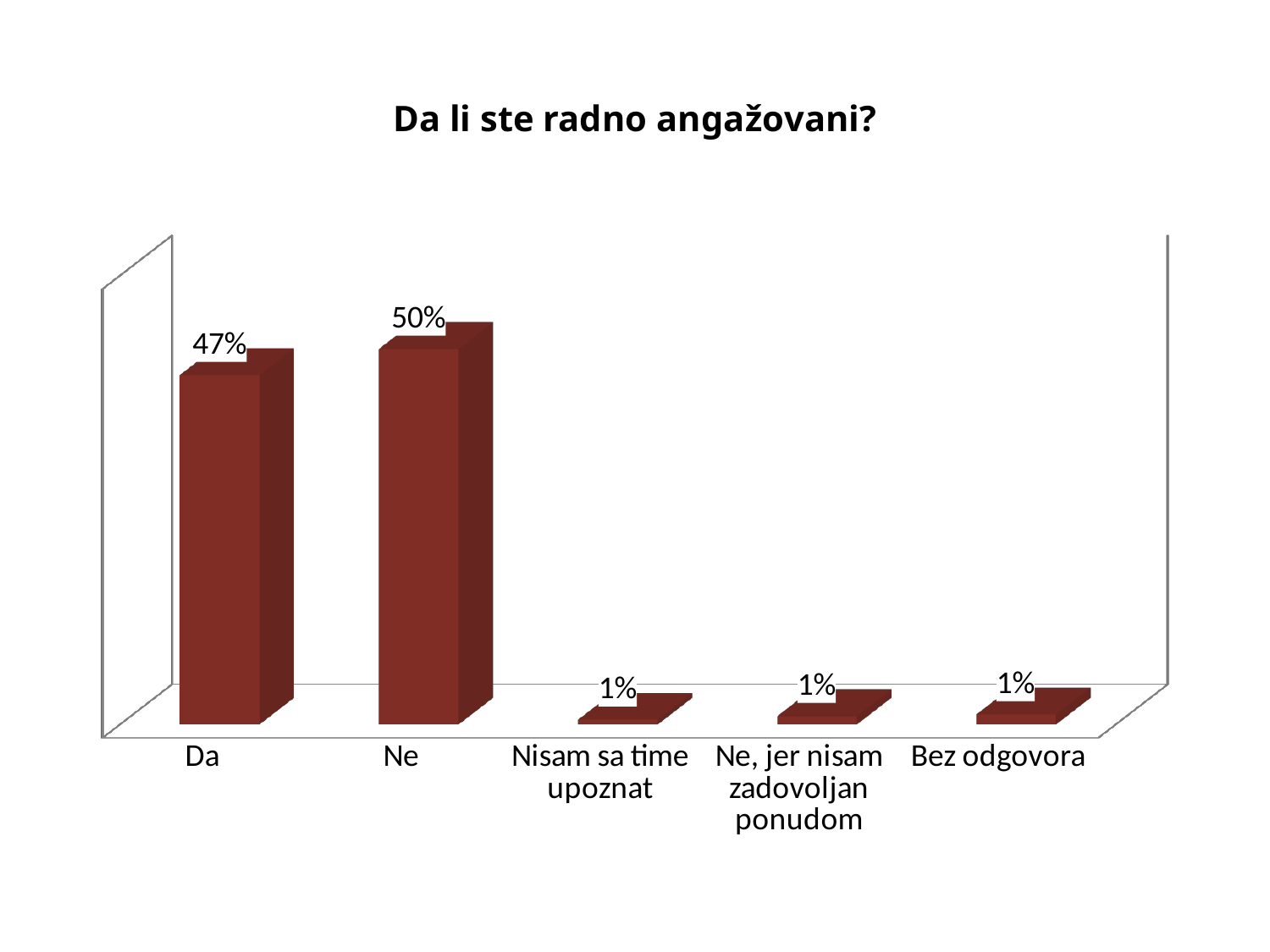
How many categories have a value of 1%? 3 What is the difference between the values for "Ne" and "Da"? 3% Which is larger, the value for "Da" or the value for "Ne"? Ne What is the title of the chart? Da li ste radno angažovani? What kind of chart is shown on the slide? Bar chart What is the value for "Ne"? 50% Which category has the highest value? Ne What is the difference between the values for "Da" and "Bez odgovora"? 46% What is the value for "Bez odgovora"? 1% How many categories are shown on the x axis? 5 What is the value for "Nisam sa time upoznat"? 1% What is the value for "Da"? 47%